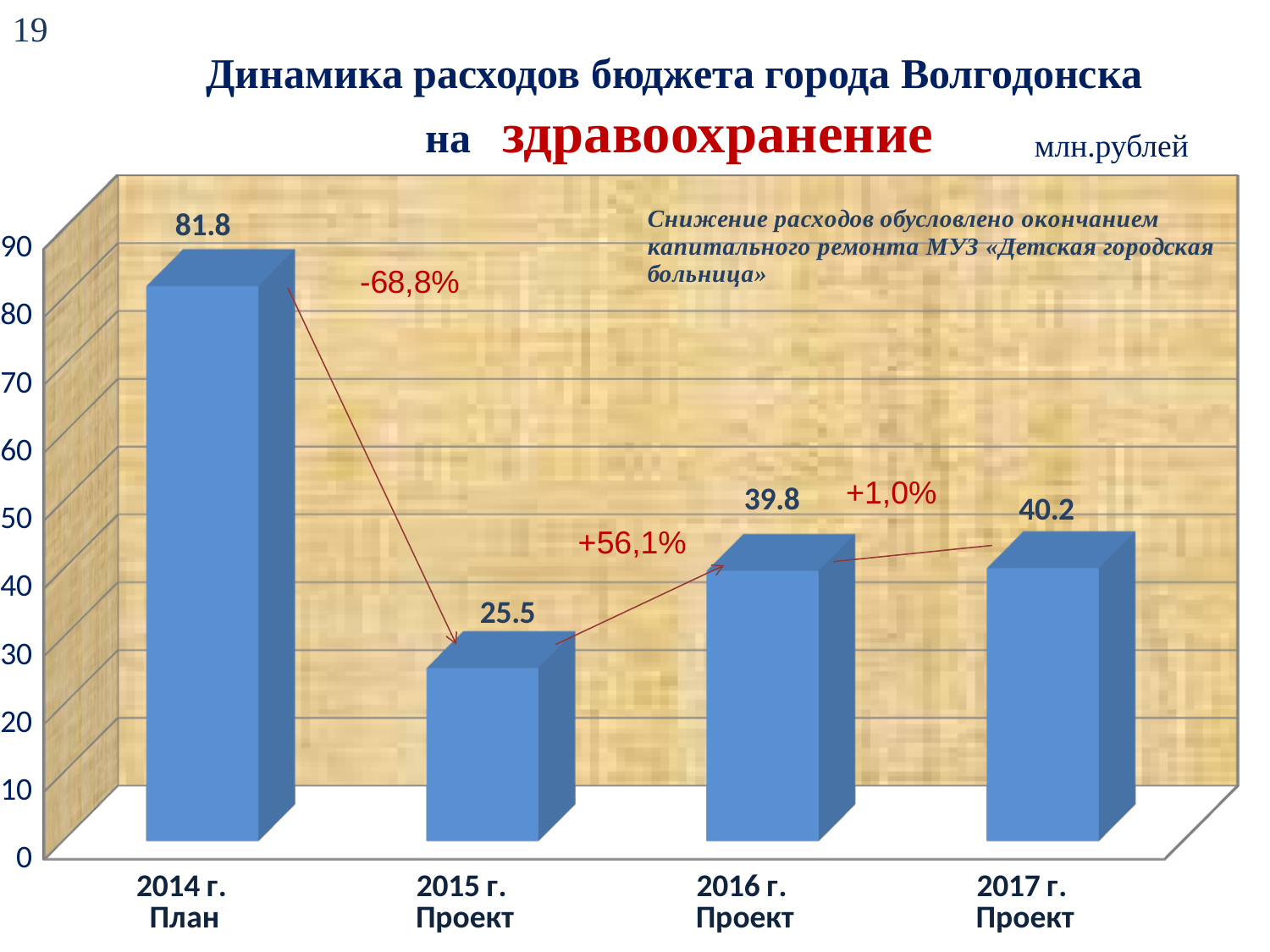
What is the value for 2015 г. Проект? 25.5 How many categories are shown on the x axis? 4 What is the value for 2016 г. Проект? 39.8 What unit of measurement is indicated for the chart? млн.рублей What is the value for 2017 г. Проект? 40.2 Which category has the highest value? 2014 г. План Which category has the lowest value? 2015 г. Проект What is the value for 2014 г. План? 81.8 What is the difference between the values for 2014 г. План and 2015 г. Проект? 56.3 Which is larger, the value for 2016 г. Проект or the value for 2015 г. Проект? 2016 г. Проект What kind of chart is this? bar chart What percentage change is shown between 2015 г. Проект and 2016 г. Проект? +56,1%